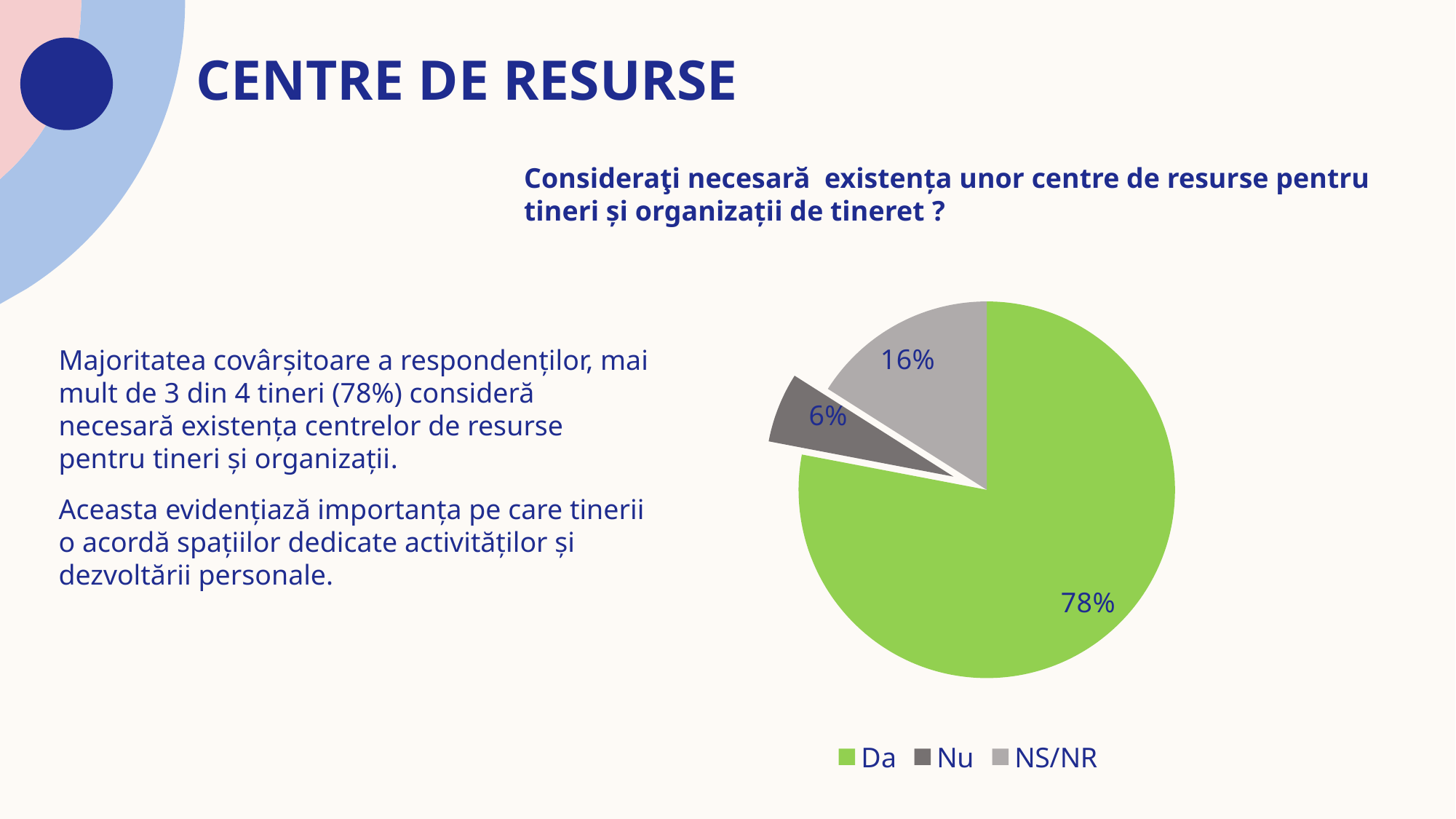
What share of respondents answered "NS/NR"? 16% What type of chart is shown on the slide? pie chart What colour is the "Da" slice in the pie chart? green What share of respondents answered "Da"? 78% What is the difference in percentage points between "NS/NR" and "Nu"? 10 What is the difference in percentage points between "Da" and "NS/NR"? 62 Which is larger, the share for "Nu" or the share for "NS/NR"? NS/NR What share of respondents answered "Nu"? 6% Which response has the largest slice of the pie? Da How many slices does the pie chart have? 3 Which response has the smallest slice of the pie? Nu How many entries does the legend list? 3